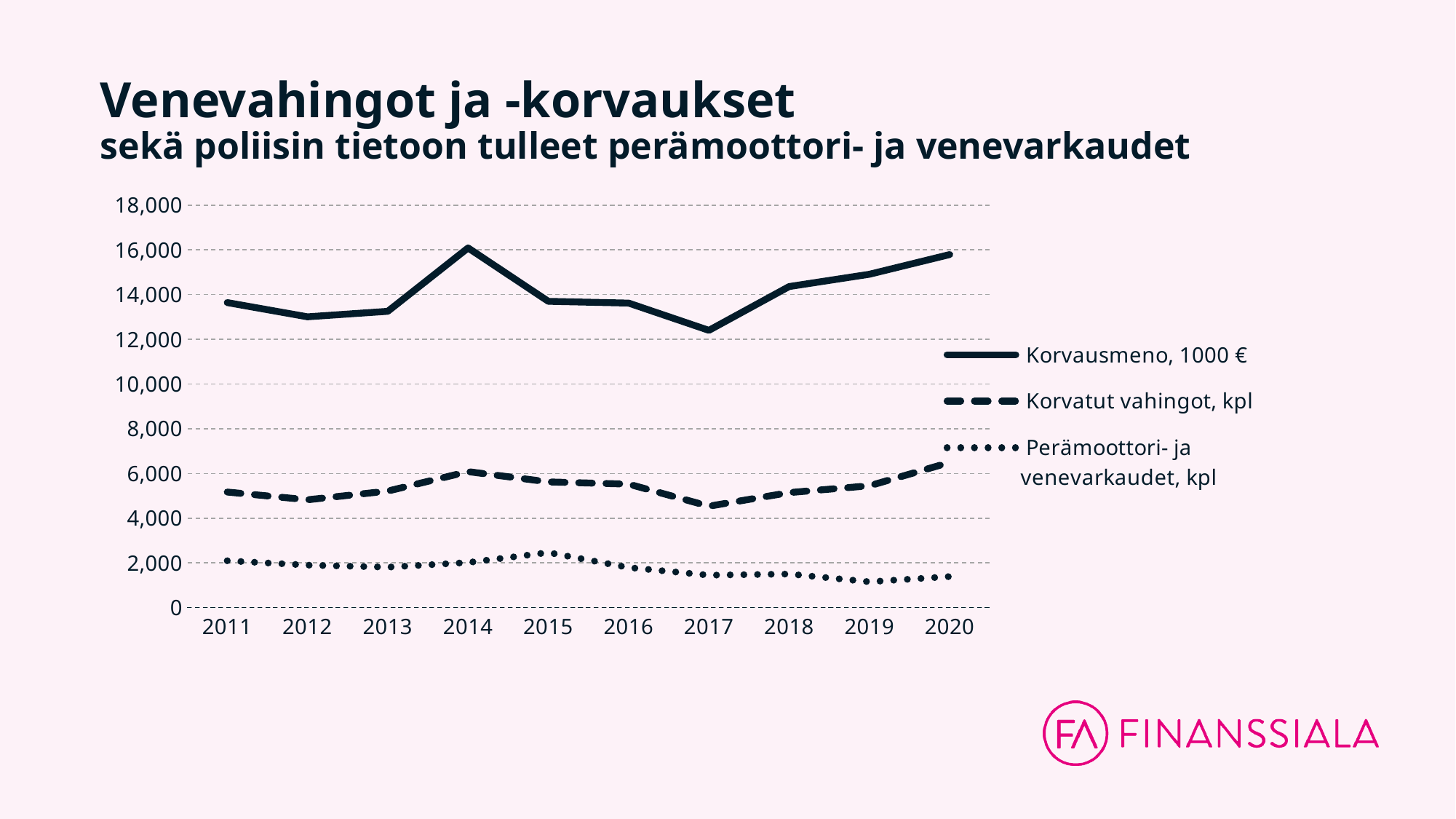
In which year is Korvatut vahingot, kpl highest? 2020 In which year is Perämoottori- ja venevarkaudet, kpl highest? 2015 Is the value for Korvausmeno, 1000 € in 2020 greater or less than 14,000? greater In which year is Korvausmeno, 1000 € highest? 2014 Which is larger: Korvausmeno, 1000 € in 2014 or in 2017? 2014 What kind of chart is shown on the slide? line chart How many years are shown on the x axis? 10 Is the value for Korvausmeno, 1000 € in 2017 greater or less than 14,000? less How many series does the legend list? 3 Does Korvausmeno, 1000 € rise or fall from 2017 to 2020? rise In which year is Korvausmeno, 1000 € lowest? 2017 Is the value for Perämoottori- ja venevarkaudet, kpl in 2019 greater or less than 2,000? less